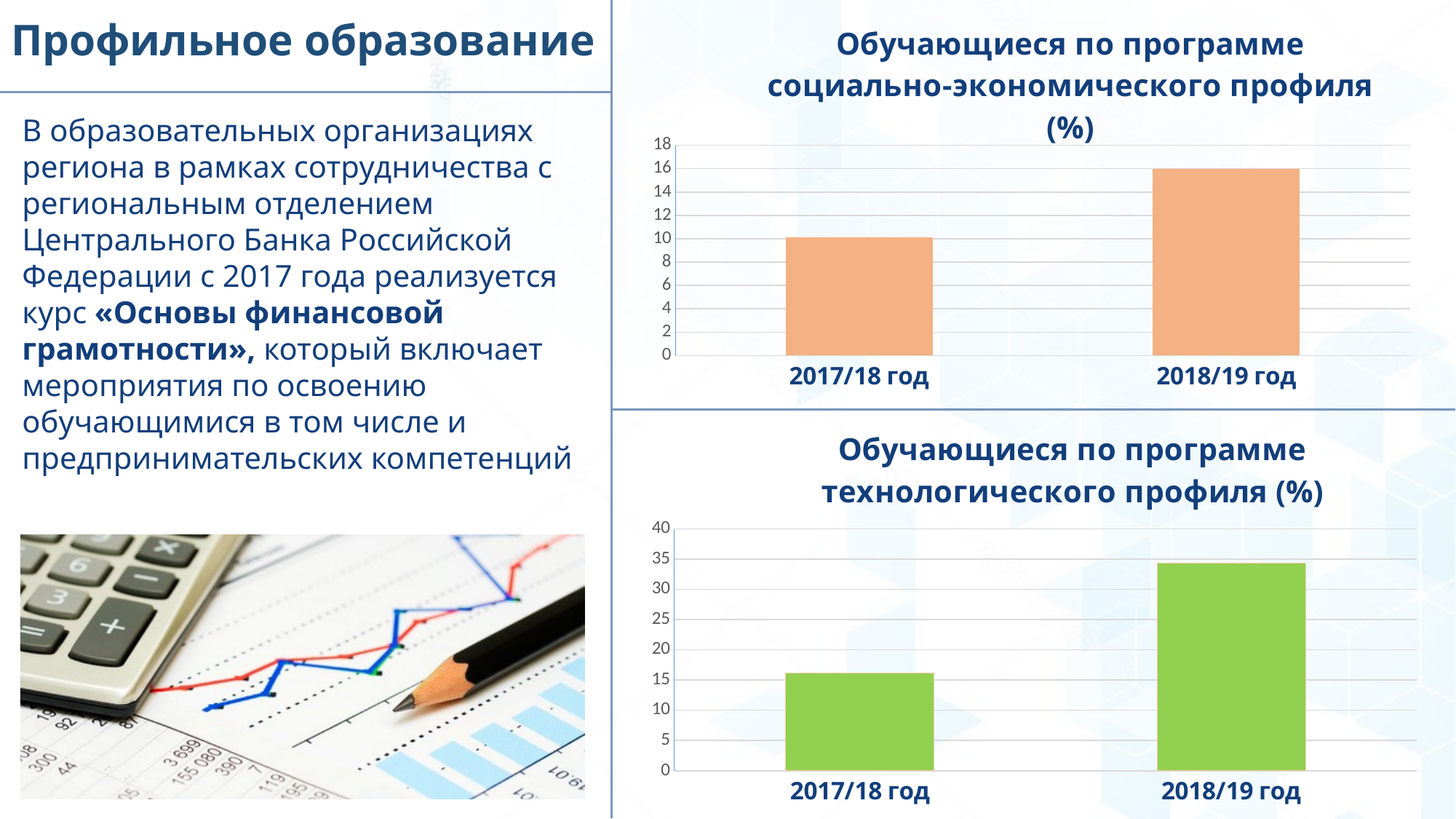
In the chart titled "Обучающиеся по программе социально-экономического профиля (%)", which year has the lower value? 2017/18 год In the chart titled "Обучающиеся по программе технологического профиля (%)", is the value for 2017/18 год greater or less than 20? less In the chart titled "Обучающиеся по программе технологического профиля (%)", which year has the higher value? 2018/19 год What colour are the bars in the chart titled "Обучающиеся по программе технологического профиля (%)"? green What kind of chart is the one titled "Обучающиеся по программе социально-экономического профиля (%)"? bar chart In the chart titled "Обучающиеся по программе социально-экономического профиля (%)", is the value for 2017/18 год greater or less than 12? less In the chart titled "Обучающиеся по программе социально-экономического профиля (%)", is the value for 2018/19 год greater or less than 14? greater In the chart titled "Обучающиеся по программе социально-экономического профиля (%)", which year has the higher value? 2018/19 год In the chart titled "Обучающиеся по программе технологического профиля (%)", do the values rise or fall from 2017/18 год to 2018/19 год? rise In the chart titled "Обучающиеся по программе социально-экономического профиля (%)", how many categories are shown on the x axis? 2 What is the maximum value shown on the y axis of the chart titled "Обучающиеся по программе технологического профиля (%)"? 40